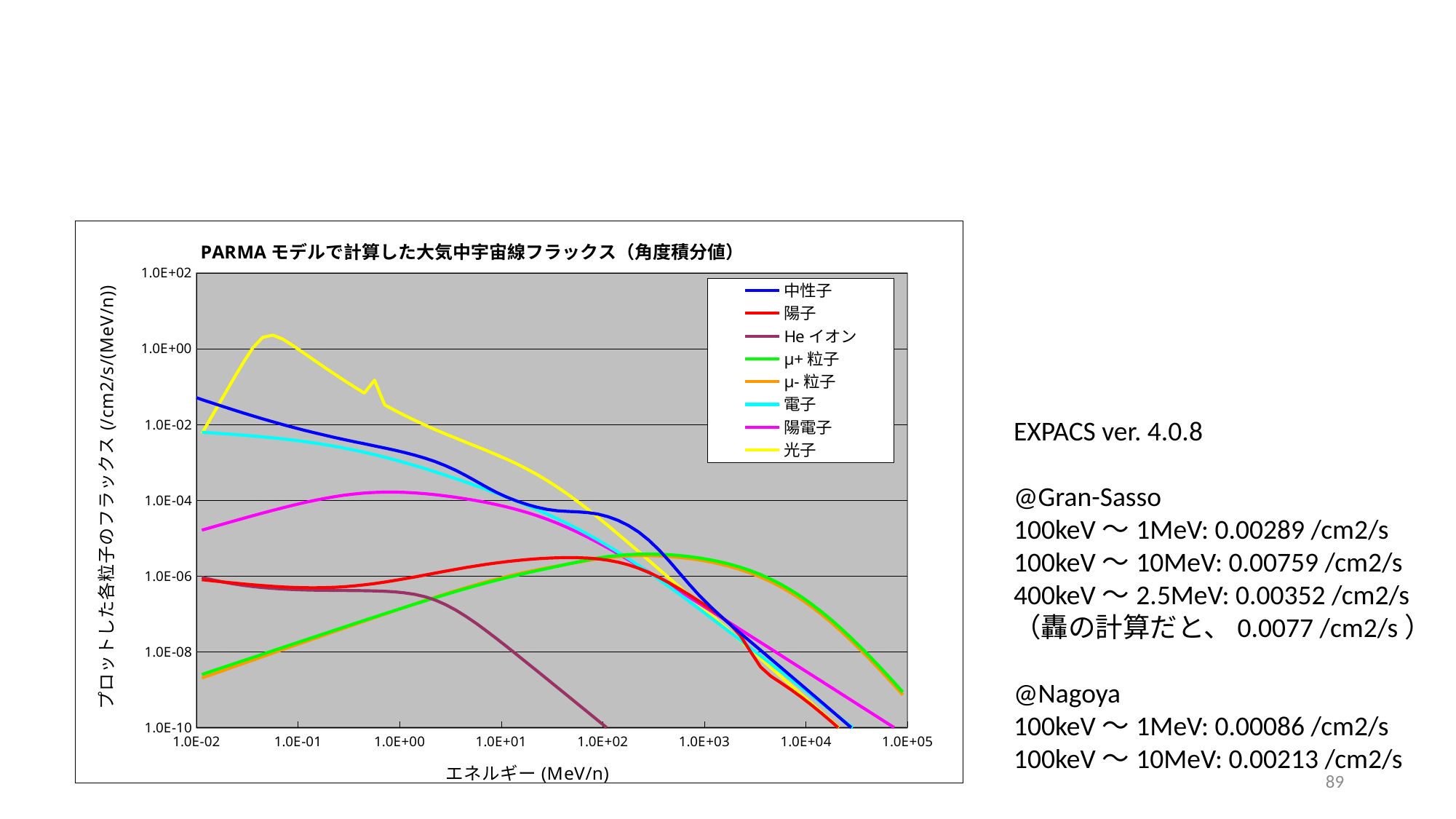
Does the He イオン series rise or fall as energy increases along the x axis? fall Is the value for 中性子 at 1.0E-02 MeV/n greater or less than 1.0E-02? greater What kind of chart is shown on the slide? line chart What is the x-axis label of the chart? エネルギー (MeV/n) Is the value for 陽電子 at 1.0E-02 MeV/n greater or less than 1.0E-04? less Which series reaches the highest flux value anywhere on the chart? 光子 How many series does the legend list? 8 Which series has the highest value at an energy of 1.0E-02 MeV/n? 中性子 What is the title of the chart? PARMA モデルで計算した大気中宇宙線フラックス（角度積分値） Which series drops to the bottom of the y axis (1.0E-10) at the lowest energy? He イオン How many tick labels are shown on the x axis? 8 Is the value for He イオン at 1.0E+00 MeV/n greater or less than 1.0E-06? less